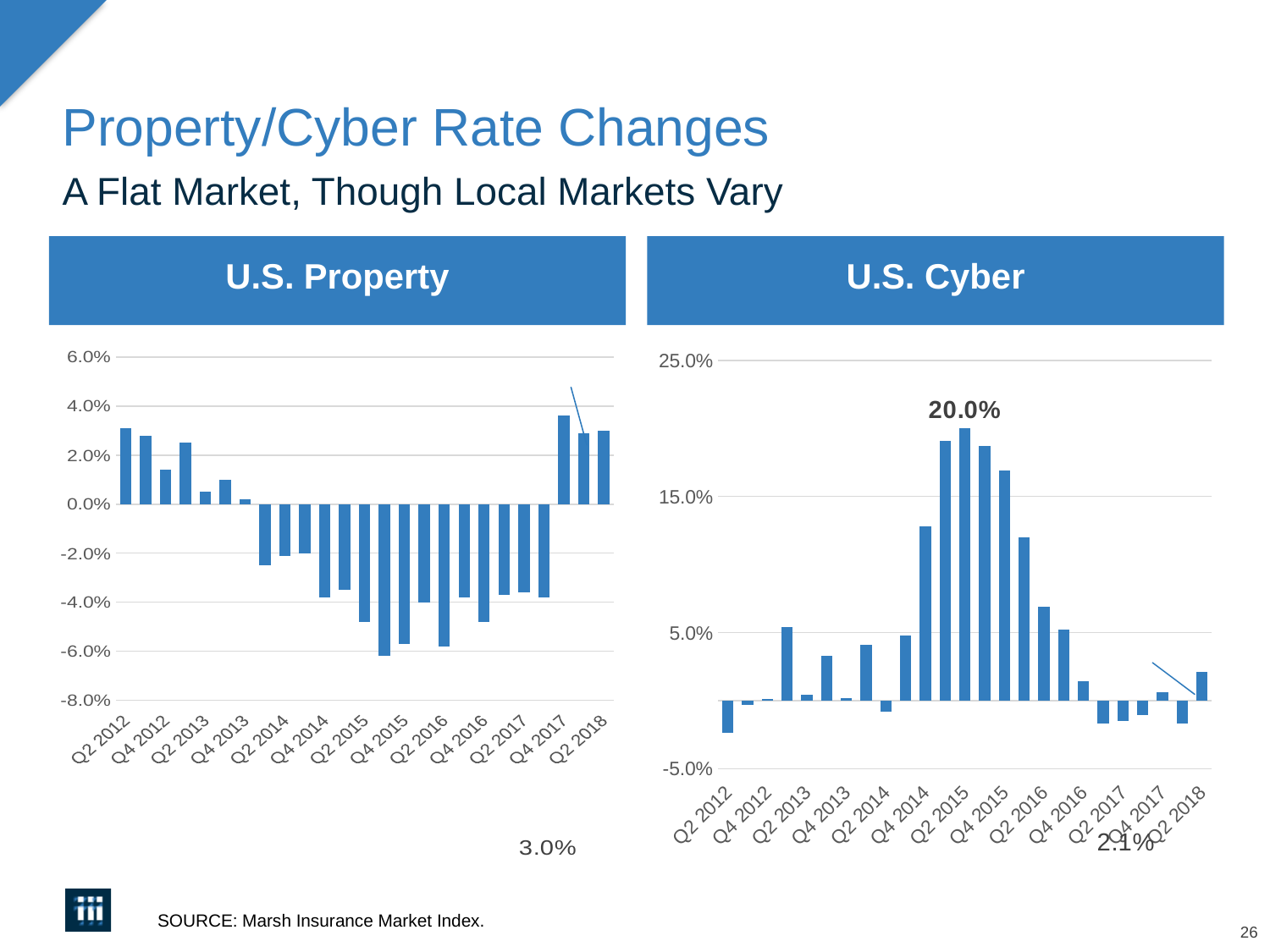
In the U.S. Cyber chart, is the value for Q4 2014 greater or less than 5.0%? greater In the U.S. Cyber chart, which quarter has the highest rate change? Q2 2015 In the U.S. Property chart, is the value for Q2 2016 greater or less than -4.0%? less What is the highest value shown on the y-axis of the U.S. Cyber chart? 25.0% In the U.S. Cyber chart, is the value for Q2 2013 greater or less than 5.0%? less In the U.S. Property chart, which is larger, the value for Q2 2012 or the value for Q2 2016? Q2 2012 What kind of chart is the U.S. Property chart? bar chart In the U.S. Cyber chart, do the values rise or fall from Q2 2015 to Q2 2017? fall How many charts are shown on the slide? 2 In the U.S. Cyber chart, which is larger, the value for Q2 2015 or the value for Q2 2018? Q2 2015 In the U.S. Cyber chart, what is the rate change labelled at the peak in Q2 2015? 20.0%